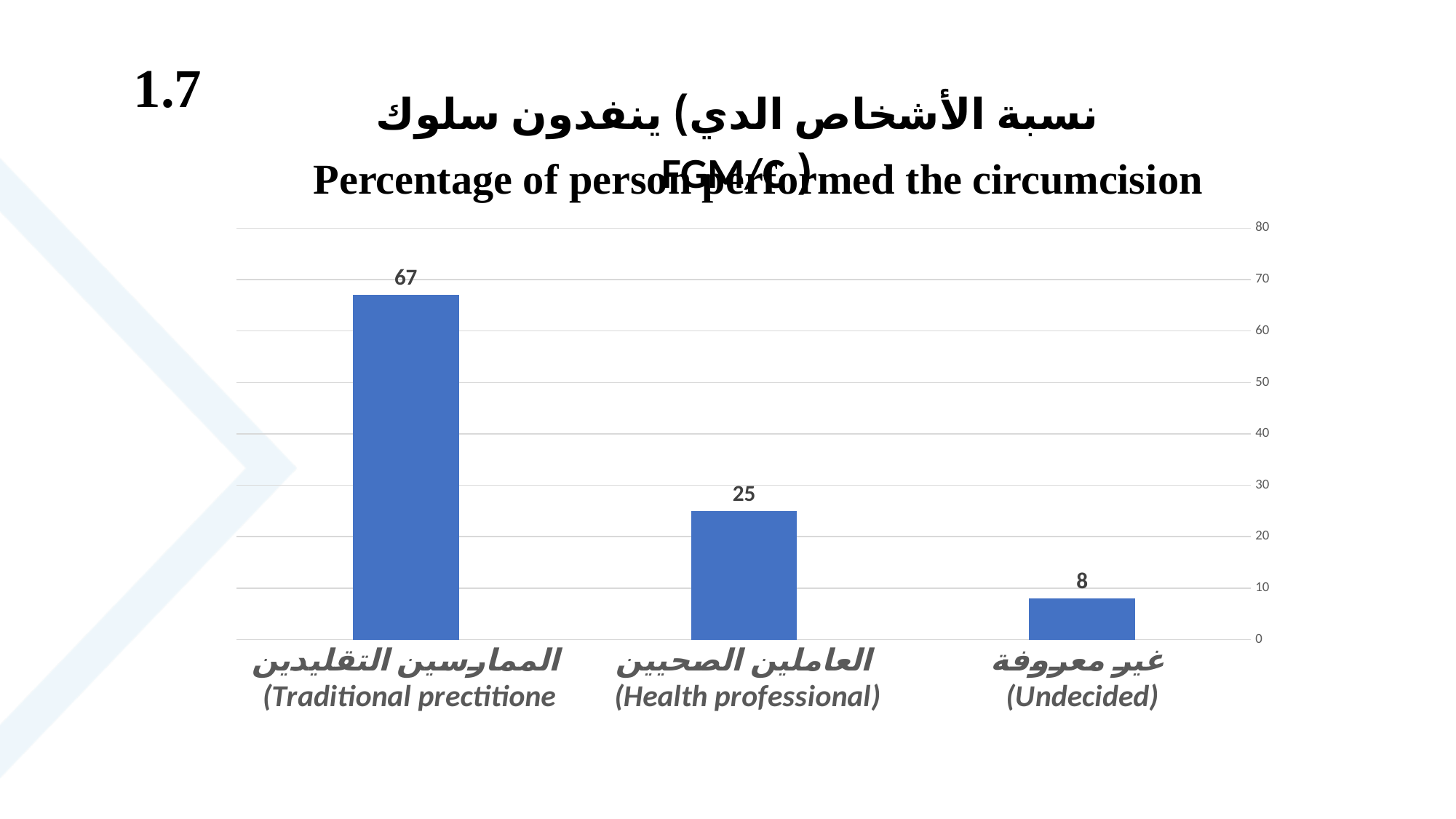
Do the values rise or fall from left to right along the x axis? fall Which category has the highest value? Traditional prectitione What is the value for Health professional? 25 Is the value for Traditional prectitione greater or less than 60? greater What kind of chart is shown on the slide? bar chart What is the value for Undecided? 8 What is the value for Traditional prectitione? 67 Which is larger, the value for Health professional or the value for Undecided? Health professional What is the difference between the values for Health professional and Undecided? 17 What is the difference between the values for Traditional prectitione and Health professional? 42 Which category has the lowest value? Undecided How many categories are shown on the x axis? 3